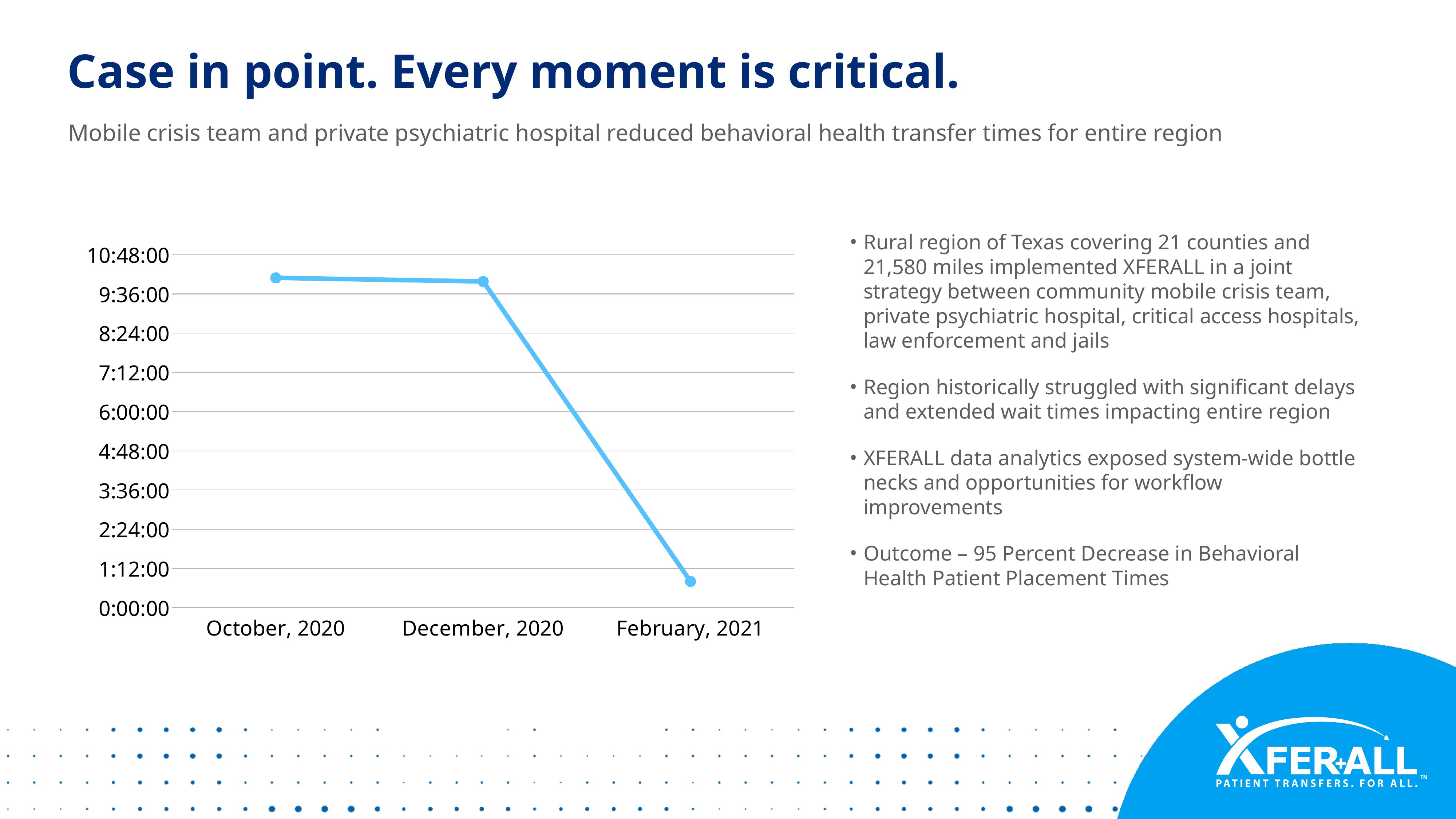
Which month has the lowest value on the chart? February, 2021 Is the value for December, 2020 greater or less than 6:00:00? greater Is the value for December, 2020 greater or less than 10:48:00? less Do the values rise or fall from October, 2020 to February, 2021? fall Which is larger, the value for October, 2020 or the value for February, 2021? October, 2020 How many data points are plotted on the chart? 3 What kind of chart is shown on the slide? line chart Is the value for October, 2020 greater or less than 9:36:00? greater Which is larger, the value for December, 2020 or the value for February, 2021? December, 2020 What is the label of the first category on the horizontal axis? October, 2020 What is the highest tick label shown on the vertical axis? 10:48:00